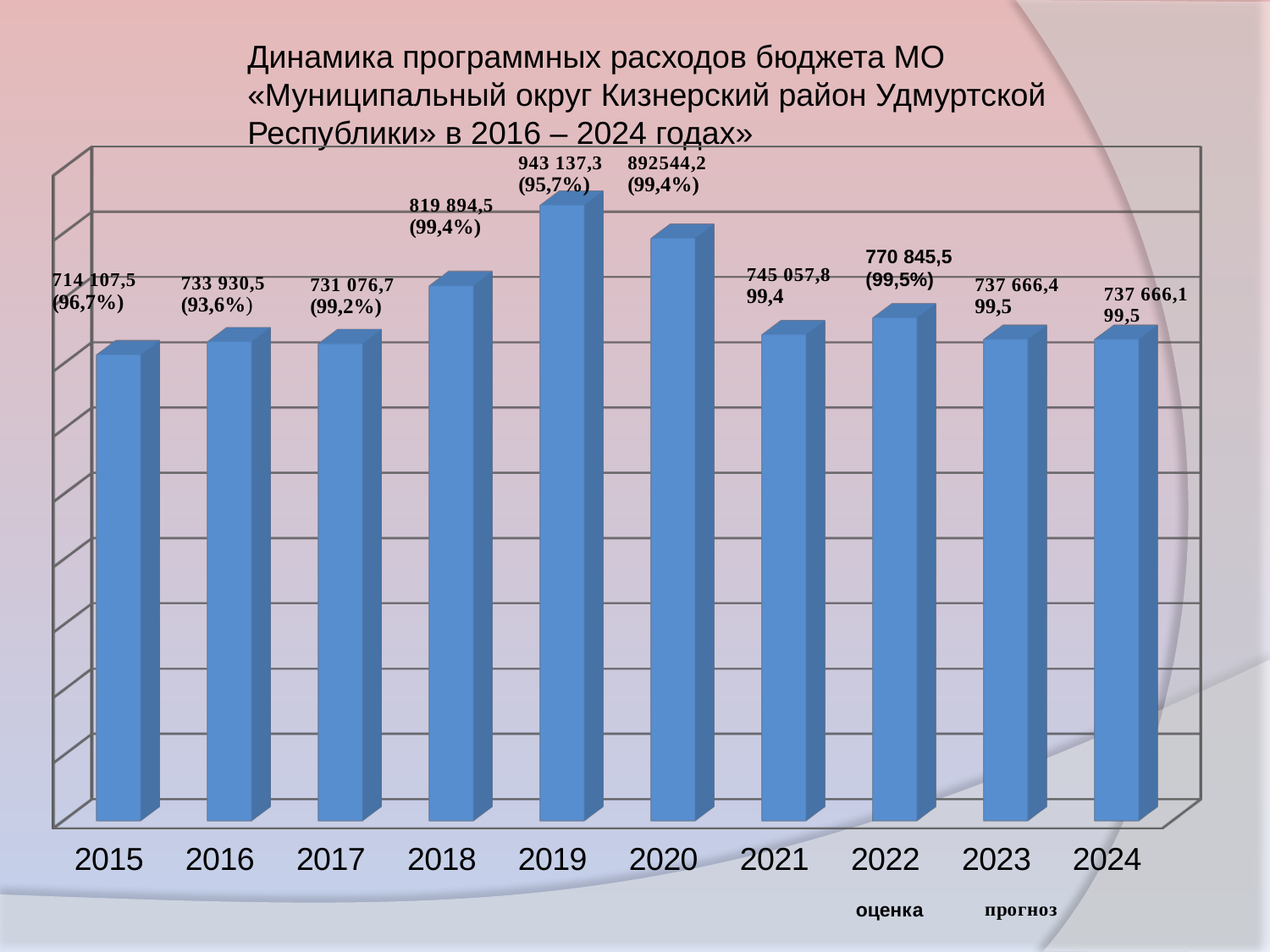
Which year has the lowest value? 2015 How many years are shown on the x axis? 10 What is the difference between the values for 2019 and 2018? 123 242,8 Do the values rise or fall from 2015 to 2019? rise Which year has the highest value? 2019 What is the value shown for 2022? 770 845,5 Which is larger, the value for 2018 or the value for 2020? 2020 What kind of chart is shown on the slide? bar chart What is the value shown for 2019? 943 137,3 What percentage is shown in parentheses for 2016? 93,6% Which year is labelled 'прогноз' (forecast) below the x axis? 2023 What is the value shown for 2015? 714 107,5